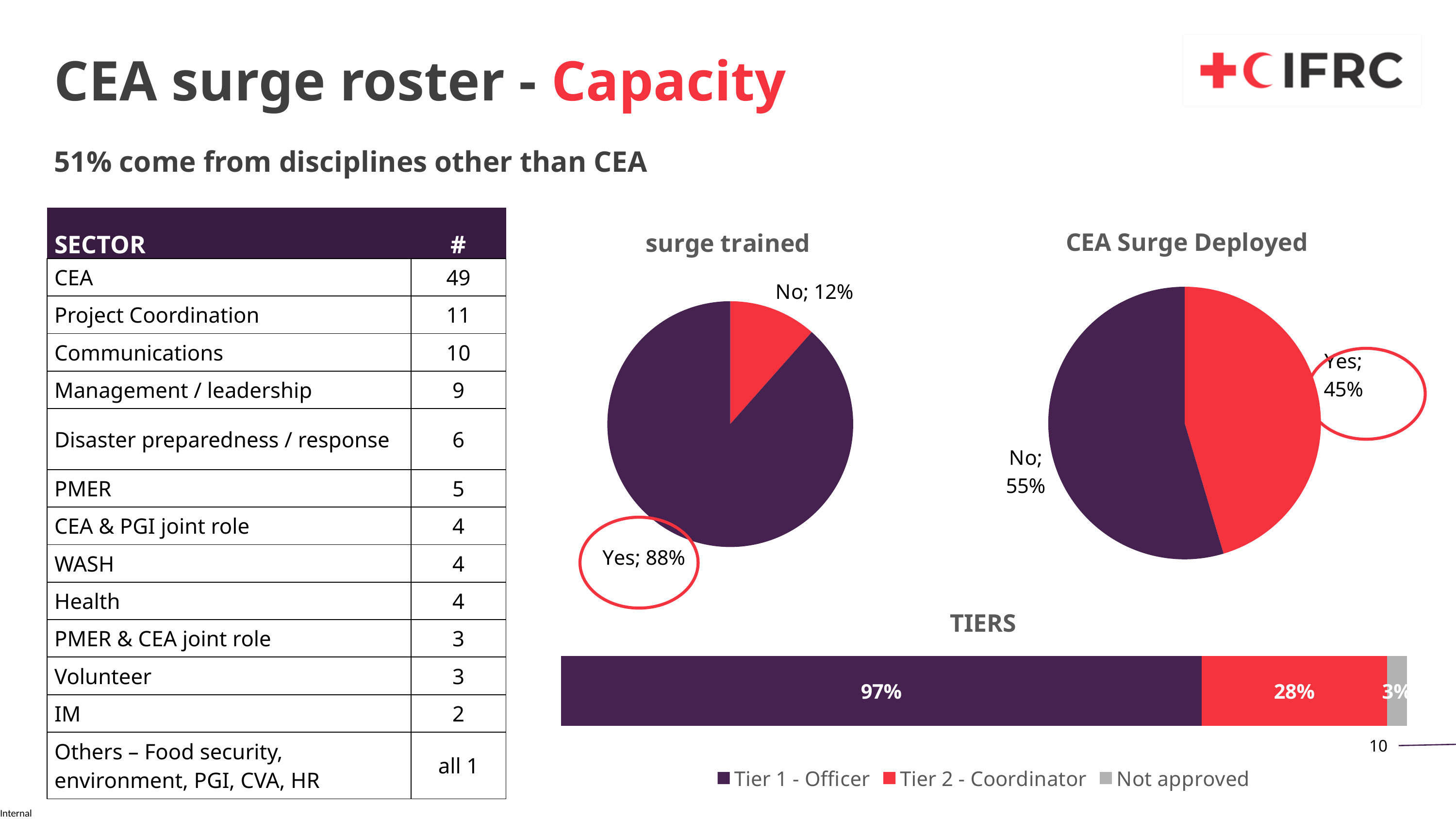
What kind of chart is the "surge trained" chart? pie chart How many series does the legend of the "TIERS" chart list? 3 In the "CEA Surge Deployed" chart, what is the difference between the "No" and "Yes" shares? 10% In the "TIERS" chart, what is the value for "Tier 1 - Officer"? 97% In the "TIERS" chart, what is the value for "Tier 2 - Coordinator"? 28% In the "CEA Surge Deployed" chart, what is the value for "Yes"? 45% In the "CEA Surge Deployed" chart, what share of the pie is "No"? 55% In the "surge trained" chart, what is the value for "No"? 12% In the "surge trained" chart, what share of the pie is "Yes"? 88% In the "surge trained" chart, which slice is larger, "Yes" or "No"? Yes In the "surge trained" chart, what is the difference between the "Yes" and "No" shares? 76% In the "CEA Surge Deployed" chart, which slice is the largest? No